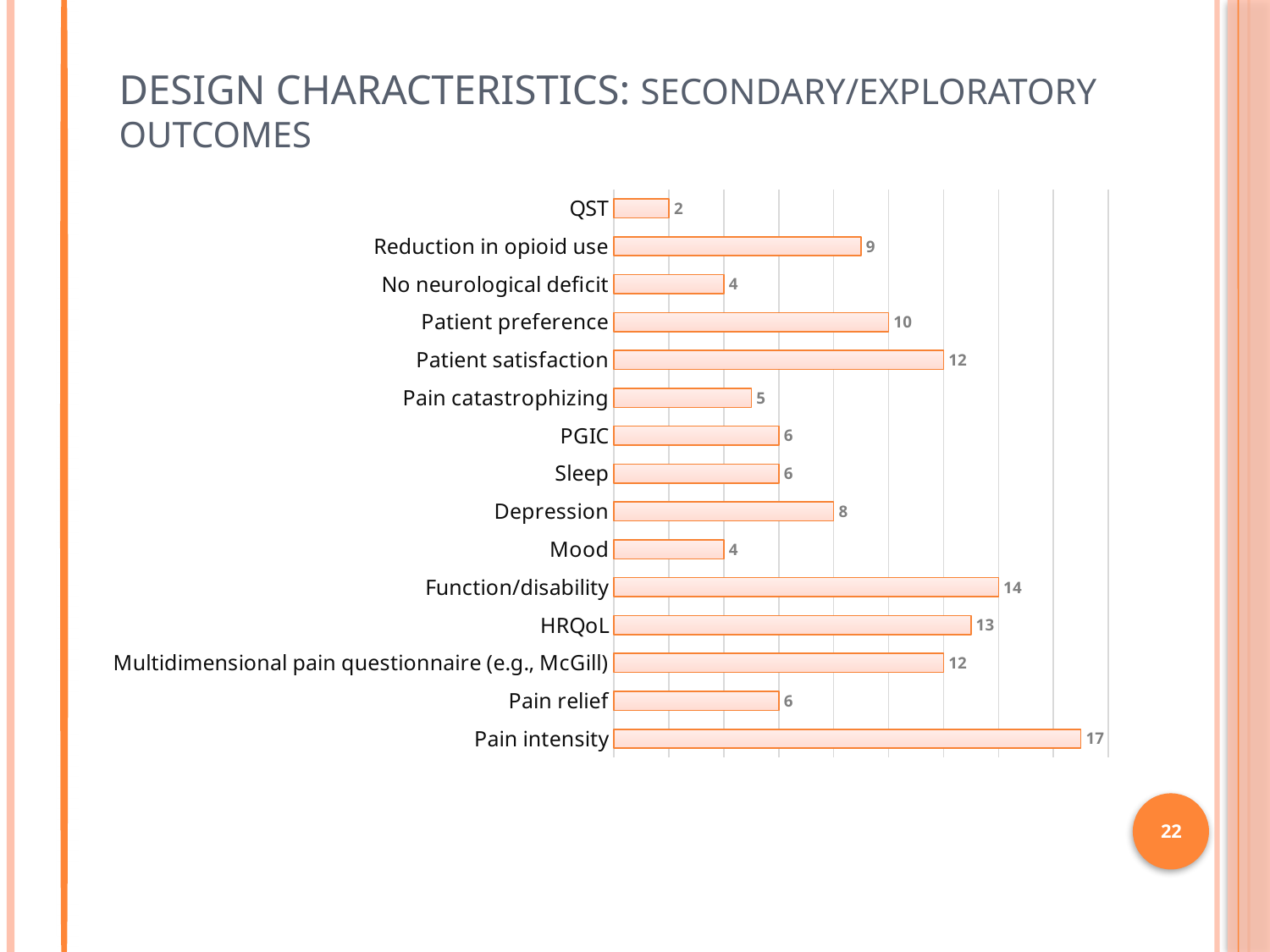
What is the value for Reduction in opioid use? 9 How many categories are shown in the chart? 15 What kind of chart is shown on the slide? Bar chart Which is larger, the value for Patient satisfaction or the value for Patient preference? Patient satisfaction What is the value for Multidimensional pain questionnaire (e.g., McGill)? 12 What is the difference between the values for Function/disability and HRQoL? 1 What is the difference between the values for Pain intensity and QST? 15 How many categories have a value of 6? 3 Which category has the lowest value? QST Which category has the highest value? Pain intensity What is the value for Pain intensity? 17 Which is larger, the value for Depression or the value for Pain catastrophizing? Depression